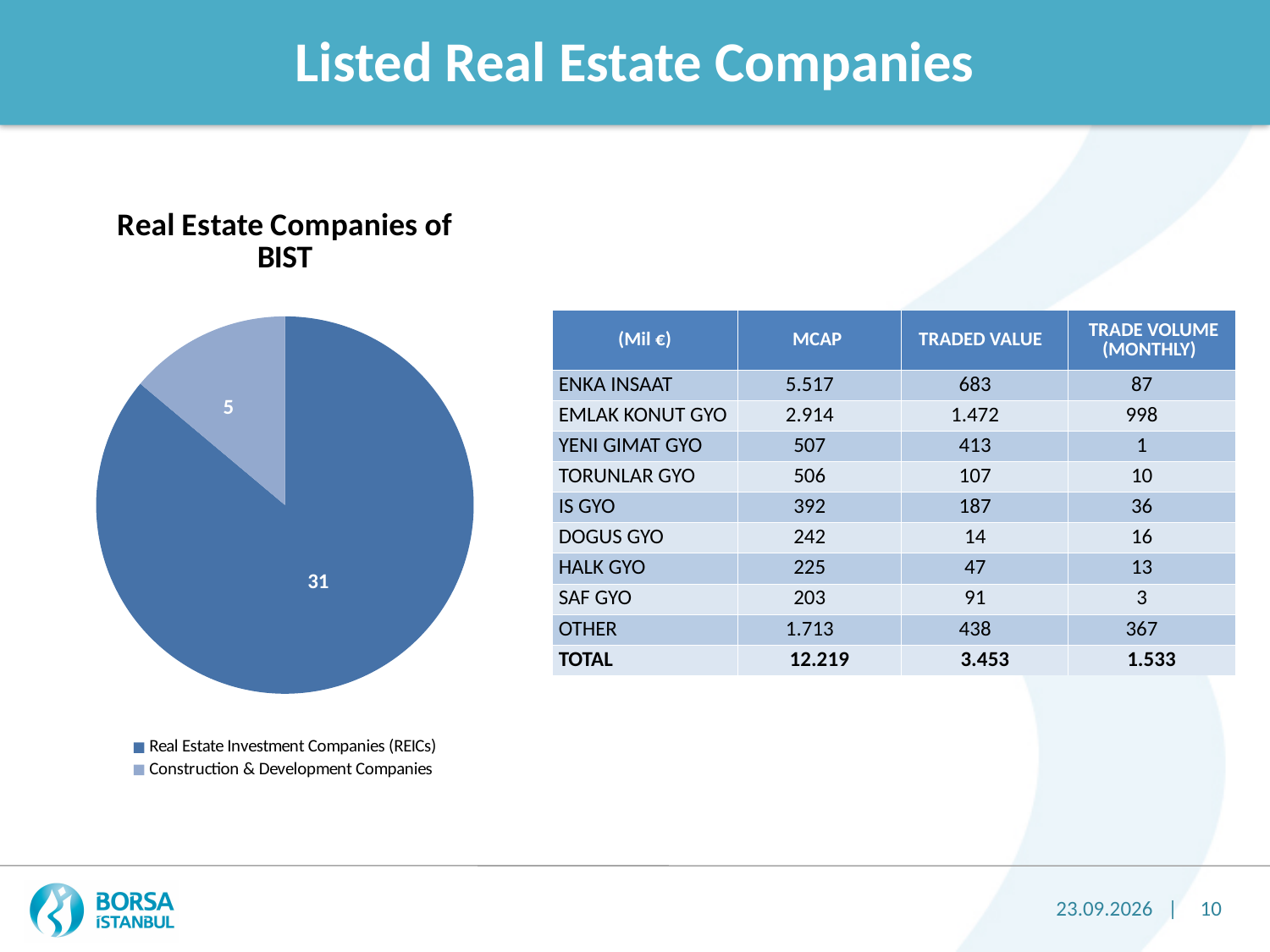
What is the difference between the REICs value and the Construction & Development Companies value in the pie chart? 26 What is the title of the pie chart? Real Estate Companies of BIST Which category has the smallest slice in the pie chart? Construction & Development Companies In the pie chart, what is the value for Construction & Development Companies? 5 How many entries does the pie chart's legend list? 2 How many categories does the pie chart show? 2 Which is larger in the pie chart: Real Estate Investment Companies (REICs) or Construction & Development Companies? Real Estate Investment Companies (REICs) In the pie chart, what is the value for Real Estate Investment Companies (REICs)? 31 Which category has the largest slice in the pie chart? Real Estate Investment Companies (REICs) What is the total of the two values shown in the pie chart? 36 What kind of chart is shown on the slide? pie chart